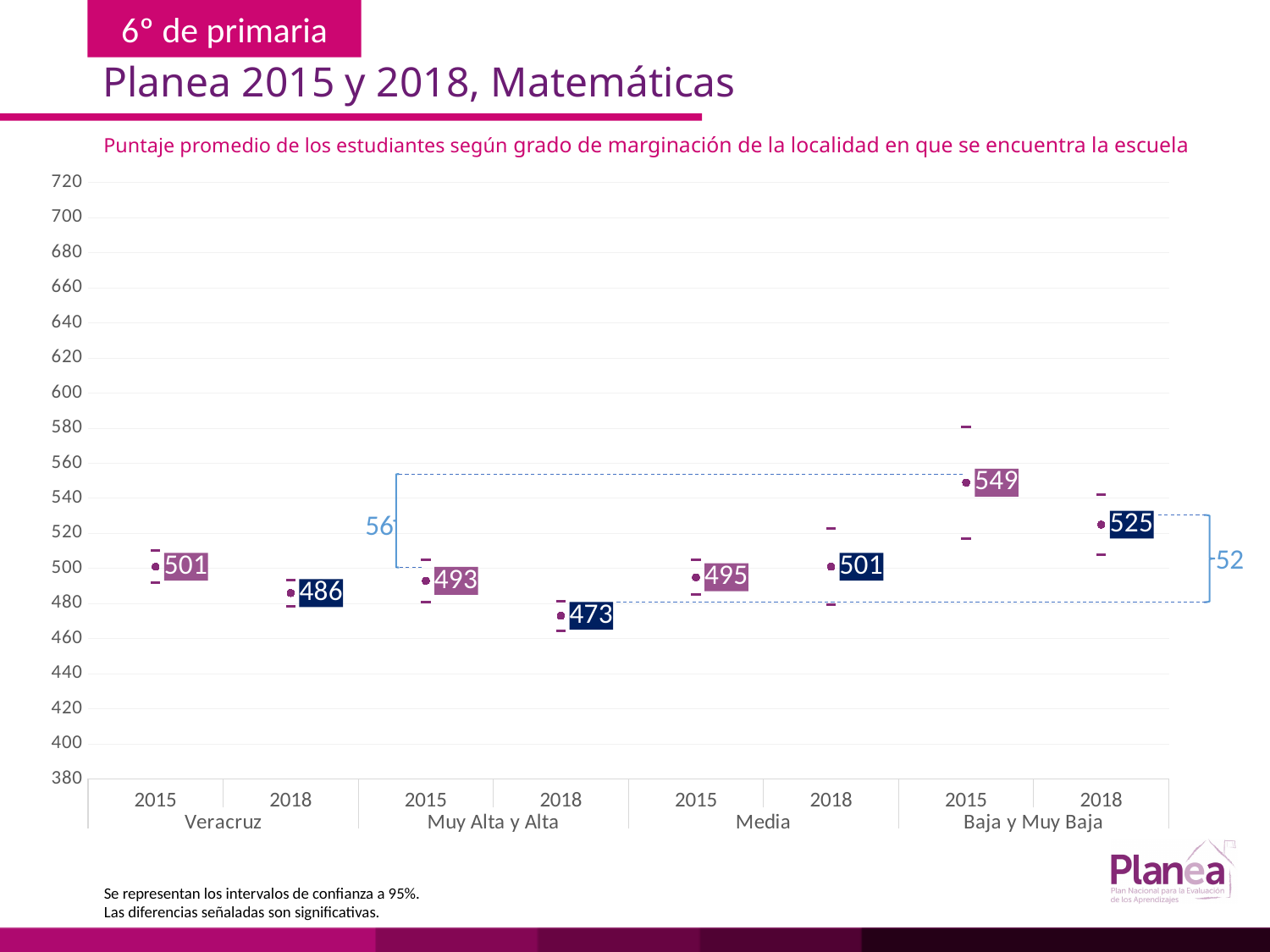
What is the difference between the Baja y Muy Baja 2015 score and the Muy Alta y Alta 2015 score? 56 What is the difference between the Baja y Muy Baja 2018 score and the Muy Alta y Alta 2018 score? 52 Which group and year has the lowest average score? Muy Alta y Alta, 2018 What is the subtitle of the chart? Puntaje promedio de los estudiantes según grado de marginación de la localidad en que se encuentra la escuela What is the average score for the Baja y Muy Baja group in 2015? 549 Which group and year has the highest average score? Baja y Muy Baja, 2015 How many data points are plotted on the chart? 8 Did the Media group's score rise or fall from 2015 to 2018? rise What is the average score for Veracruz in 2015? 501 What is the average score for the Media group in 2018? 501 Which is larger, the Veracruz score in 2015 or in 2018? 2015 What is the average score for the Muy Alta y Alta marginación group in 2018? 473